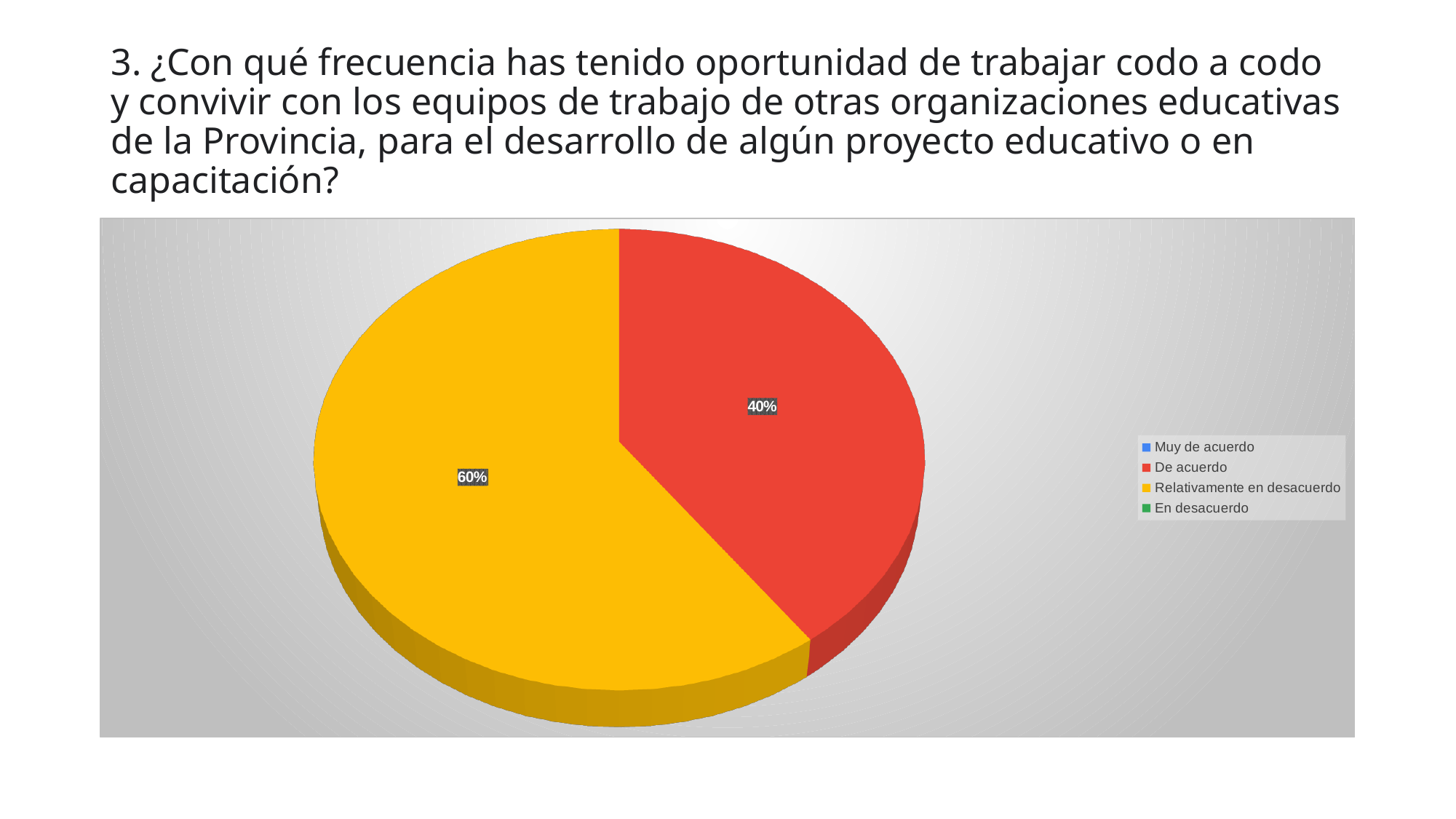
What colour does the legend assign to "Muy de acuerdo"? blue Which is larger, the slice for "De acuerdo" or the slice for "Relativamente en desacuerdo"? Relativamente en desacuerdo Is the share for "De acuerdo" greater or less than 50%? less What share of the pie does "Relativamente en desacuerdo" represent? 60% How many slices are visible in the pie? 2 What is the difference in percentage points between the "Relativamente en desacuerdo" slice and the "De acuerdo" slice? 20 percentage points How many entries does the legend list? 4 What kind of chart is shown on the slide? pie chart What colour is the slice for "De acuerdo"? red Which category has the largest slice of the pie? Relativamente en desacuerdo What share of the pie does "De acuerdo" represent? 40%